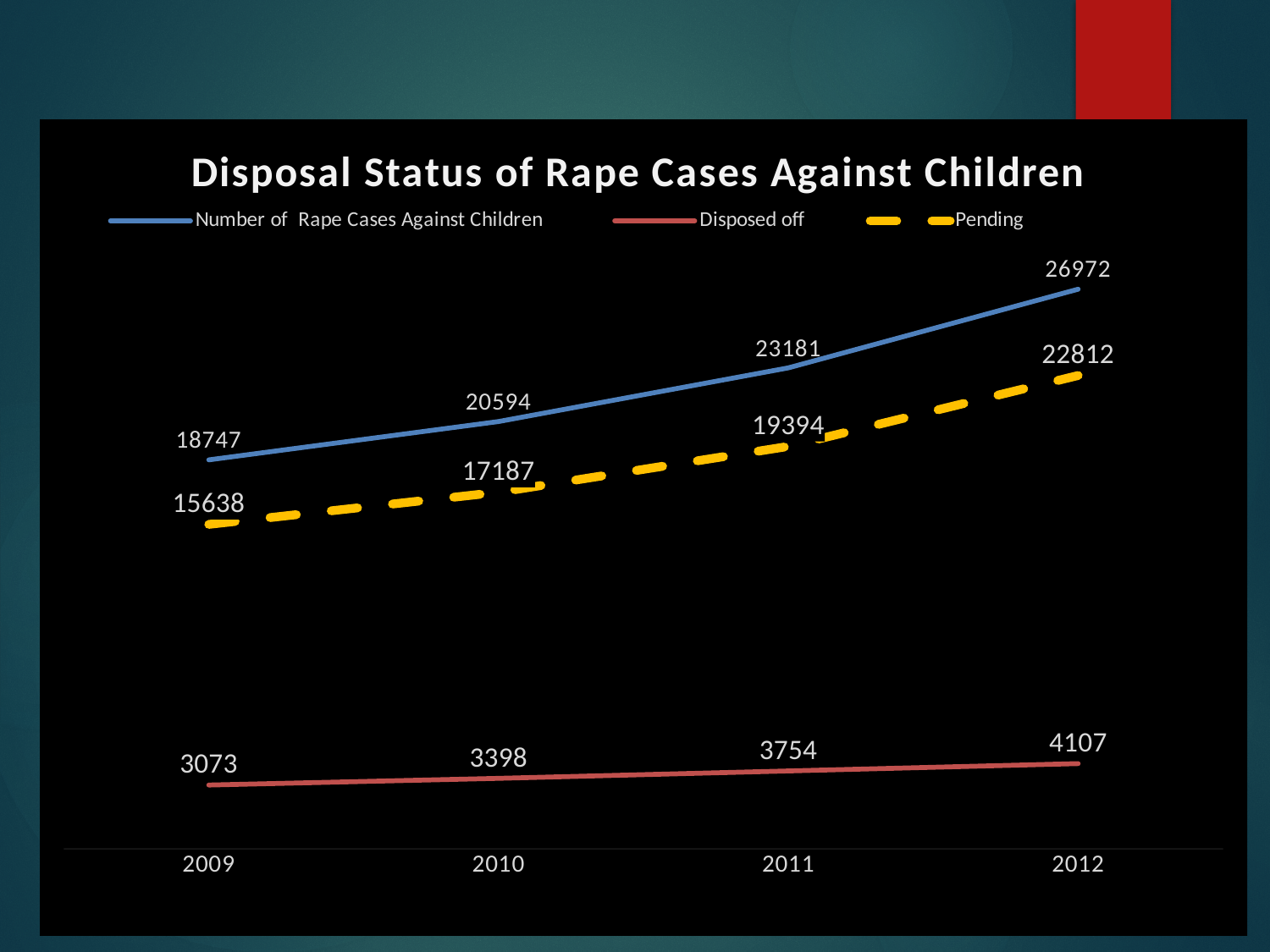
How many series does the legend list? 3 In which year is the Number of Rape Cases Against Children highest? 2012 How many years are shown on the x axis? 4 What kind of chart is shown on the slide? Line chart In which year is the Disposed off value lowest? 2009 What is the Number of Rape Cases Against Children in 2012? 26972 What is the title of the chart? Disposal Status of Rape Cases Against Children Do the Pending values rise or fall from 2009 to 2012? Rise What is the Disposed off value for 2011? 3754 Which is larger in 2011: the Pending value or the Disposed off value? Pending What is the Pending value for 2010? 17187 What is the difference between the Number of Rape Cases Against Children and the Pending value in 2009? 3109